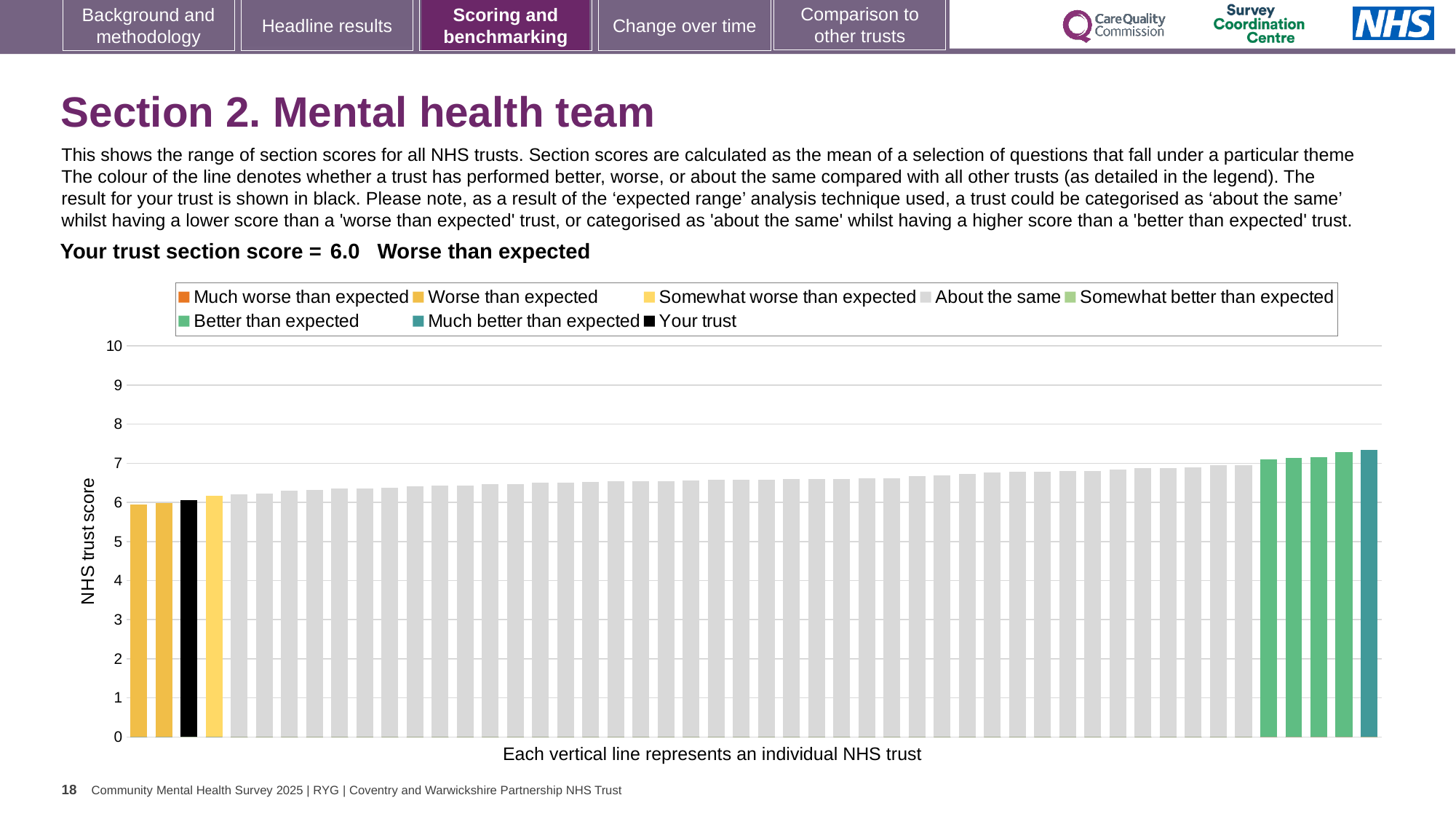
Is the black 'Your trust' bar higher or lower than the rightmost bar? lower How many categories does the chart legend list? 8 Which legend category is your trust's section score placed in? Worse than expected Is the value of the rightmost bar greater or less than 7? greater What is the label on the vertical axis of the chart? NHS trust score Is the value of the black 'Your trust' bar greater or less than 7? less What is the section score for your trust shown on the slide? 6.0 How many bars are coloured as 'Much better than expected'? 1 Is the value of the black 'Your trust' bar greater or less than 5? greater What kind of chart is shown on the slide? bar chart Which legend category does the highest bar on the chart belong to? Much better than expected Do the bar values rise or fall from left to right along the x axis? rise